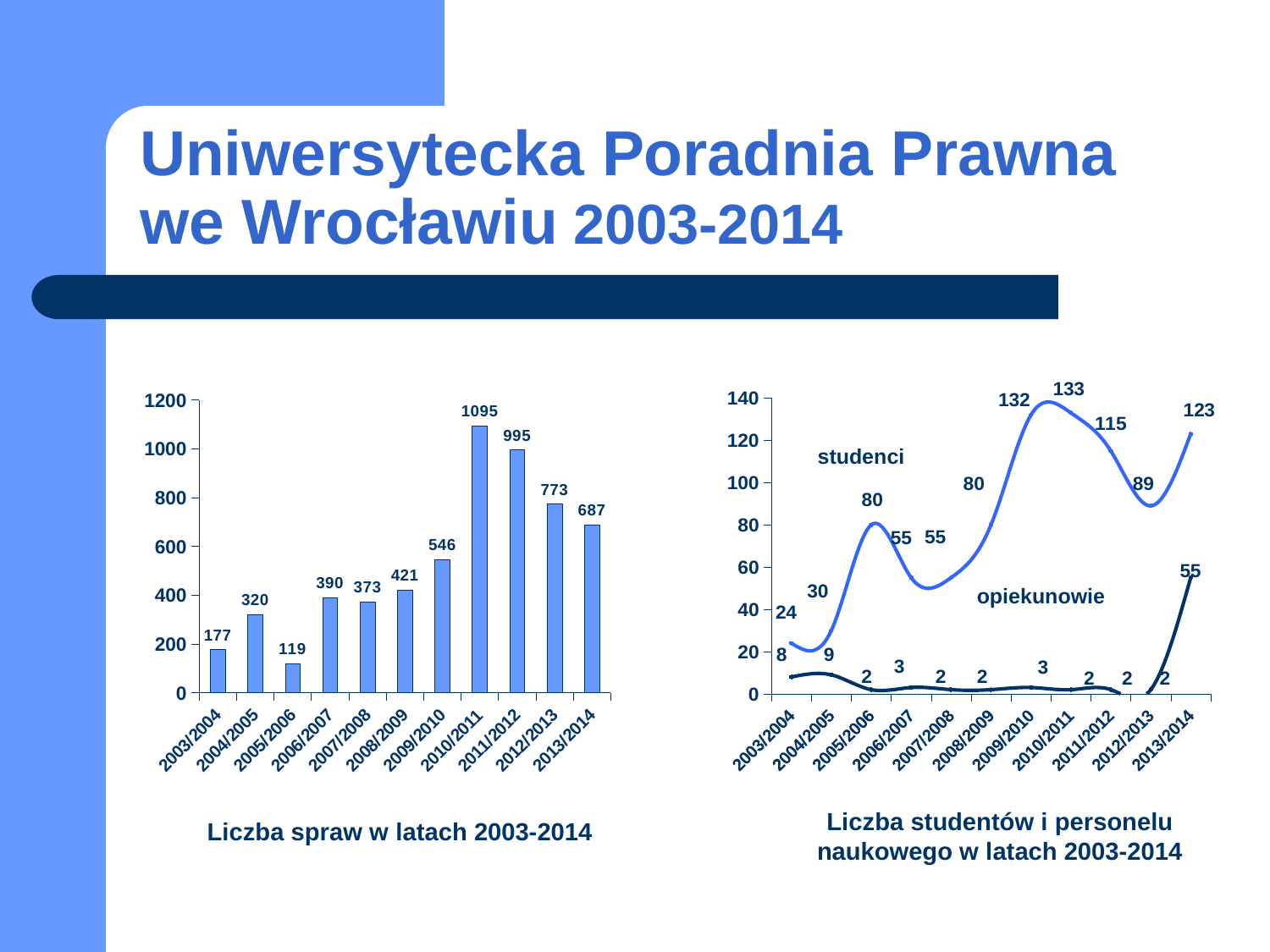
In the left chart (Liczba spraw w latach 2003-2014), which year has the lowest value? 2005/2006 What kind of chart is the left chart (Liczba spraw w latach 2003-2014)? bar chart In the right chart (Liczba studentów i personelu naukowego), what is the difference between studenci and opiekunowie in 2013/2014? 68 In the left chart (Liczba spraw w latach 2003-2014), how many years are shown on the x axis? 11 In the right chart (Liczba studentów i personelu naukowego), in which year does the studenci series reach its highest value? 2010/2011 In the left chart (Liczba spraw w latach 2003-2014), what is the value for 2010/2011? 1095 In the right chart (Liczba studentów i personelu naukowego), what is the value for opiekunowie in 2013/2014? 55 In the right chart (Liczba studentów i personelu naukowego), which is larger in 2012/2013: studenci or opiekunowie? studenci What kind of chart is the right chart (Liczba studentów i personelu naukowego)? line chart In the left chart (Liczba spraw w latach 2003-2014), which year has the highest value? 2010/2011 In the right chart (Liczba studentów i personelu naukowego), what is the value for studenci in 2009/2010? 132 In the left chart (Liczba spraw w latach 2003-2014), what is the difference between the values for 2011/2012 and 2012/2013? 222